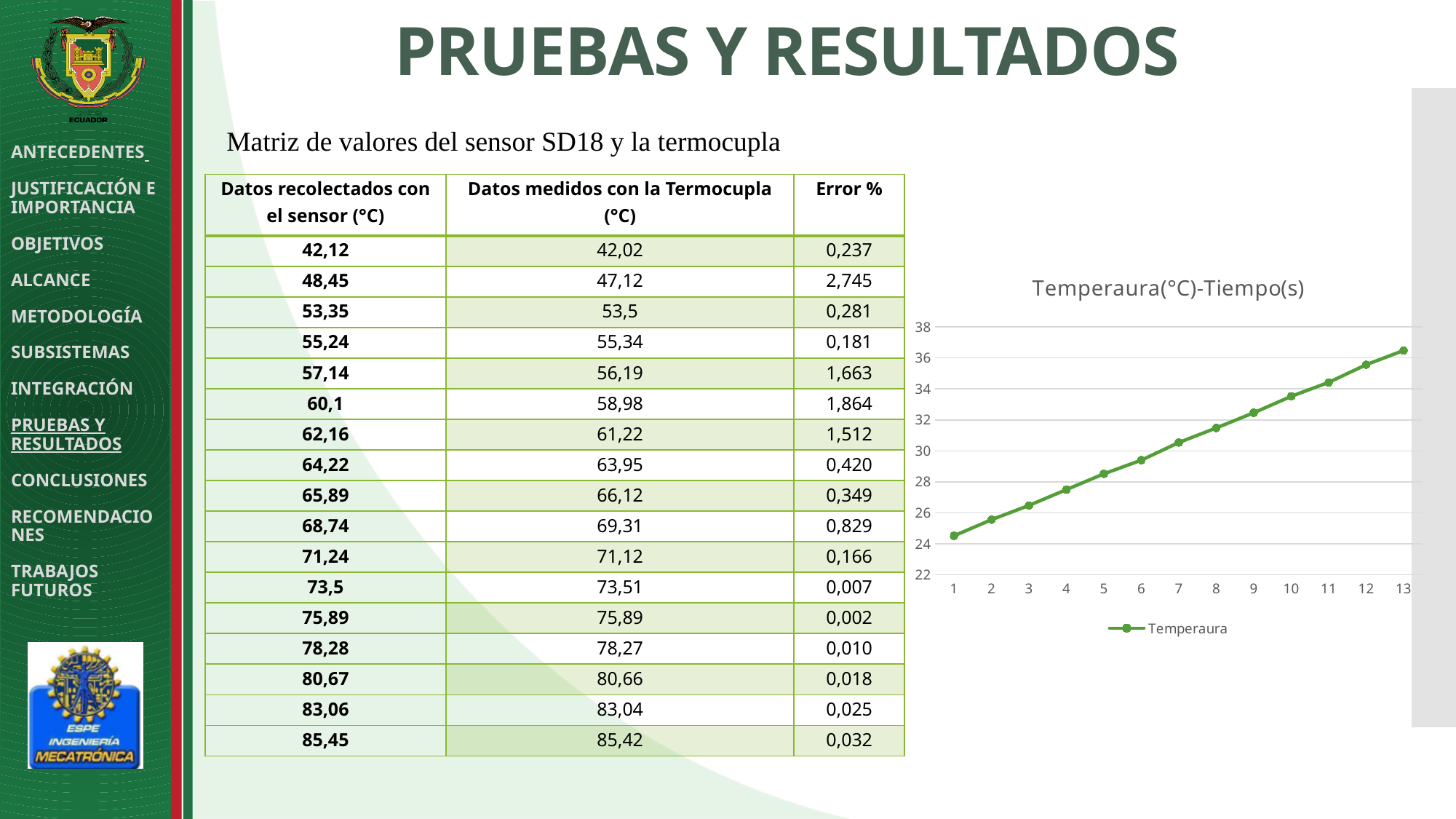
At which time point is the temperature lowest on the line chart? 1 Do the values on the line chart rise or fall as time goes from 1 to 13? rise Is the temperature at time point 1 greater or less than 26? less Is the temperature at time point 7 greater or less than 28? greater How many series does the legend of the line chart list? 1 Is the temperature at time point 10 greater or less than 32? greater How many data points are plotted on the line chart? 13 What kind of chart is shown on the slide? line chart At which time point is the temperature highest on the line chart? 13 What is the title of the line chart? Temperaura(°C)-Tiempo(s) Which is larger on the line chart, the temperature at time point 3 or at time point 9? time point 9